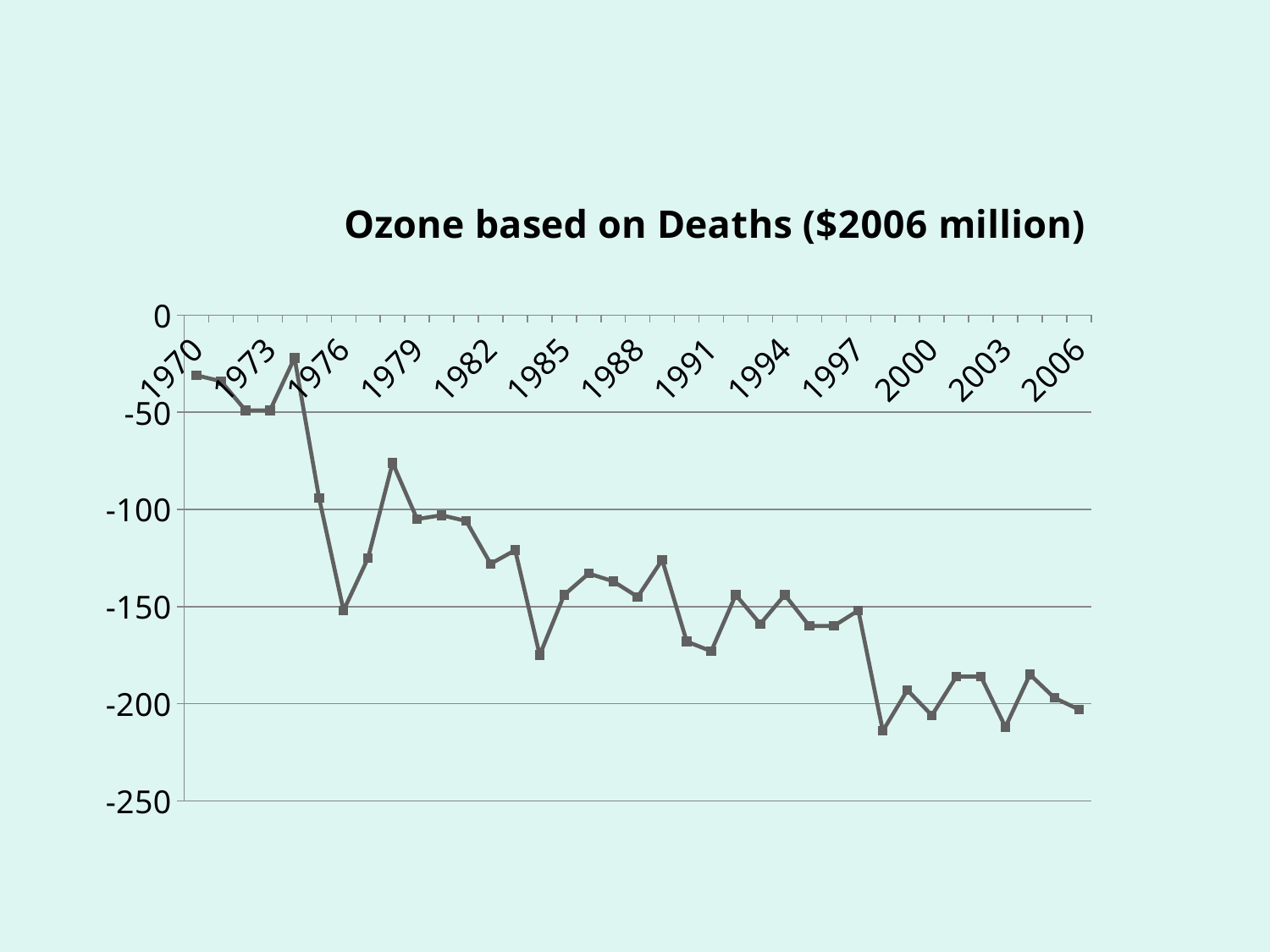
Is the value for 2003 greater or less than -200? less Is the value for 1979 greater or less than -50? less What is the title of the chart? Ozone based on Deaths ($2006 million) What is the lowest value shown on the vertical axis? -250 Is the value for 1982 greater or less than -100? less Do the values generally rise or fall from 1970 to 2006? Fall Which year has the larger value, 1970 or 2006? 1970 How many data points are plotted on the line (one per year from 1970 to 2006)? 37 What kind of chart is shown on the slide? Line chart